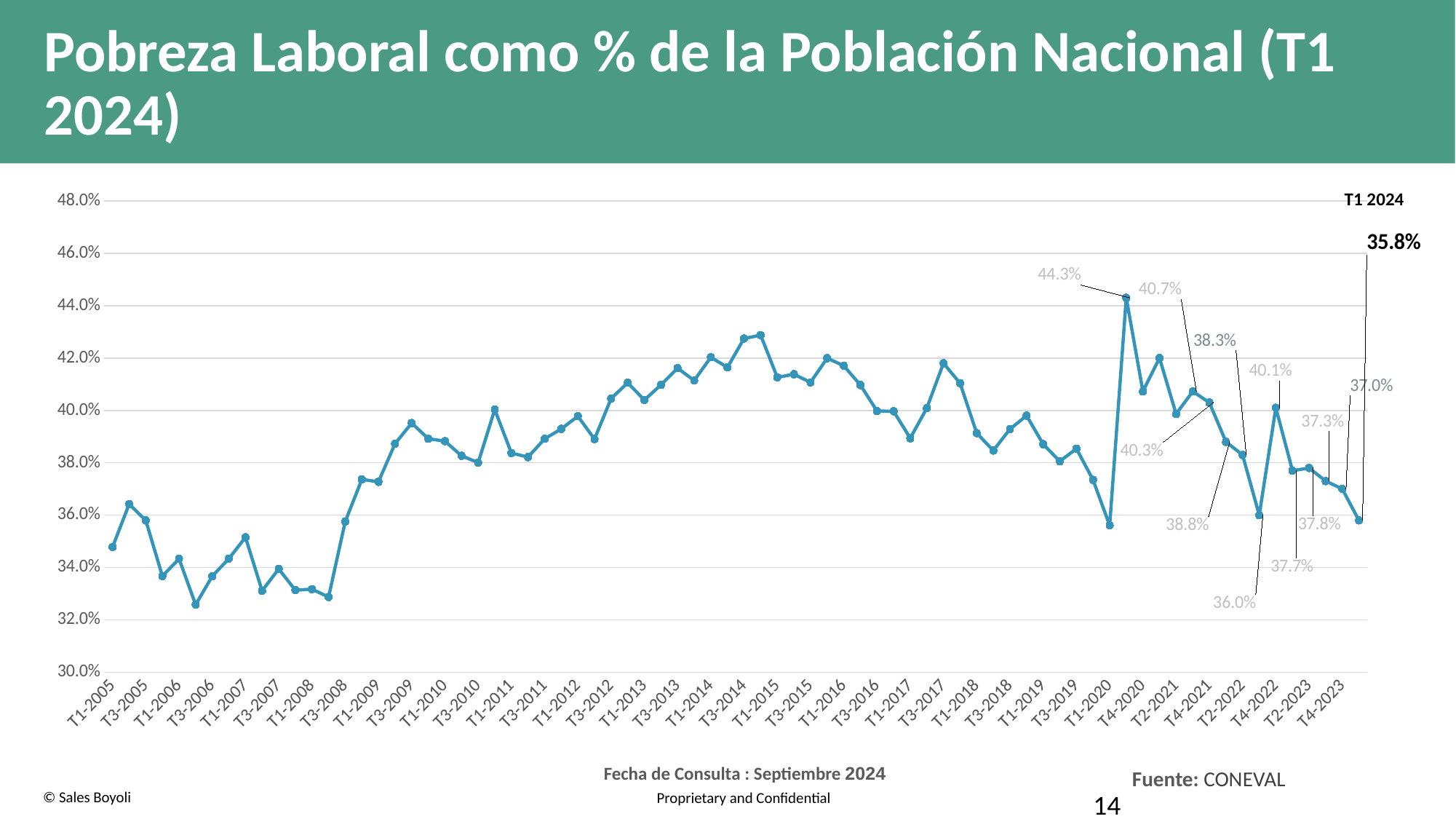
What is the difference between the labeled values 38.3% and 36.0% in 2022? 2.3 percentage points Is the value for T3-2014 greater or less than 42.0%? greater Which is larger, the value for T4-2023 (37.0%) or the value for T1 2024 (35.8%)? T4-2023 Does the series generally rise or fall from T1-2005 to T3-2014? rise Is the value for T3-2009 greater or less than 40.0%? less What is the highest value labeled on the chart, reached at the 2020 spike? 44.3% What kind of chart is shown on the slide? line chart What is the difference between the 2020 peak value of 44.3% and the T1 2024 value of 35.8%? 8.5 percentage points What is the highest value shown on the vertical axis? 48.0% Is the value for T1-2005 greater or less than 36.0%? less What is the labor poverty value shown for T1 2024? 35.8% Does the series rise or fall from T4-2022 to T1 2024? fall